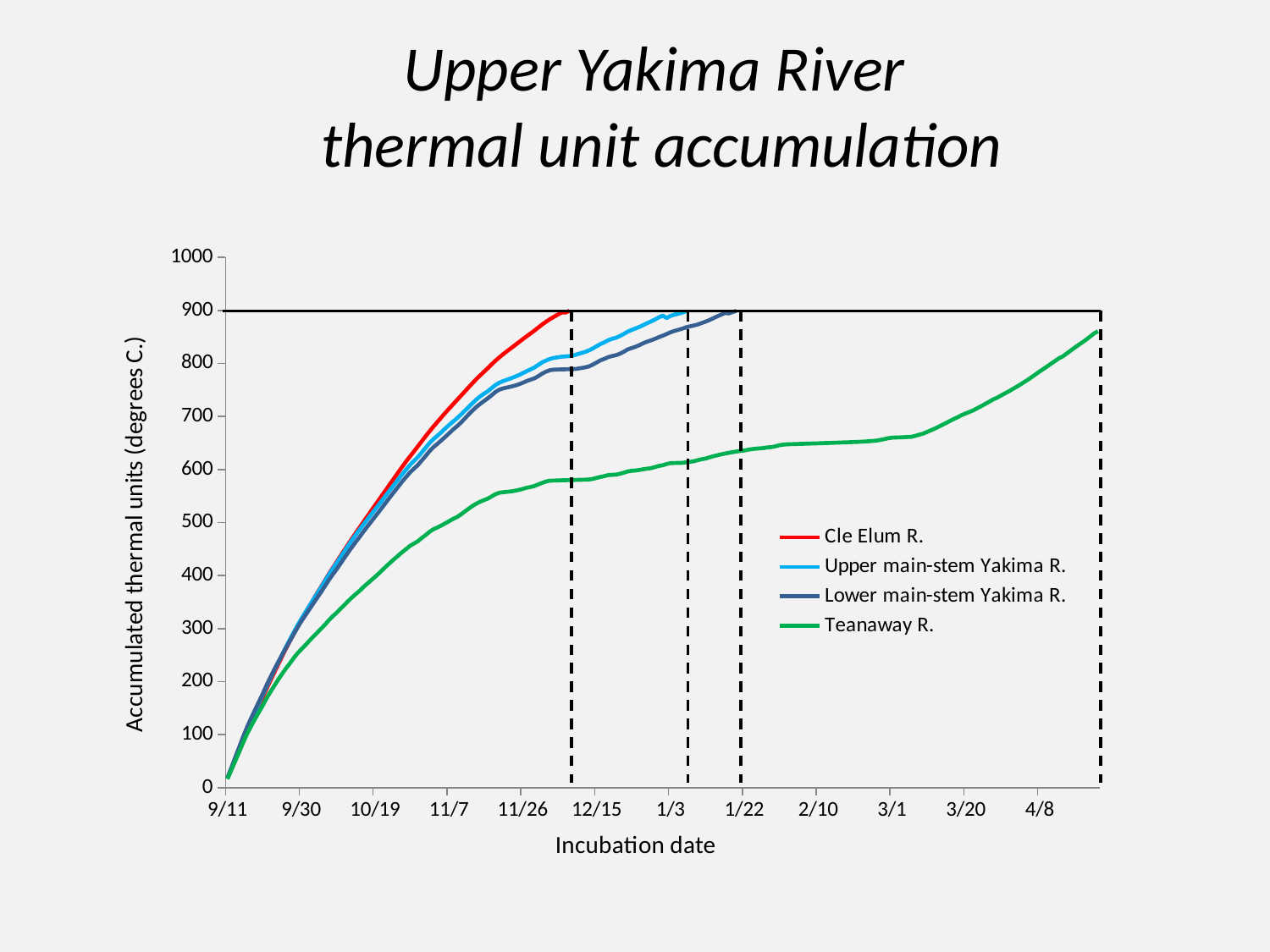
What is the title of the chart? Upper Yakima River thermal unit accumulation Is the value for Teanaway R. at 12/15 greater or less than 700? less Do the accumulated thermal unit values rise or fall along the x axis for each series? rise Is the value for Lower main-stem Yakima R. at 12/15 greater or less than 700? greater Which series reaches the 900 line first? Cle Elum R. How many series does the legend list? 4 At 11/26, which series has the higher value, Cle Elum R. or Teanaway R.? Cle Elum R. What are the series names listed in the legend? Cle Elum R., Upper main-stem Yakima R., Lower main-stem Yakima R., Teanaway R. What kind of chart is shown on the slide? line chart Which series has the lowest value at 1/3? Teanaway R. At what value on the y axis is the solid horizontal line drawn? 900 Is the value for Teanaway R. at 4/8 greater or less than 700? greater